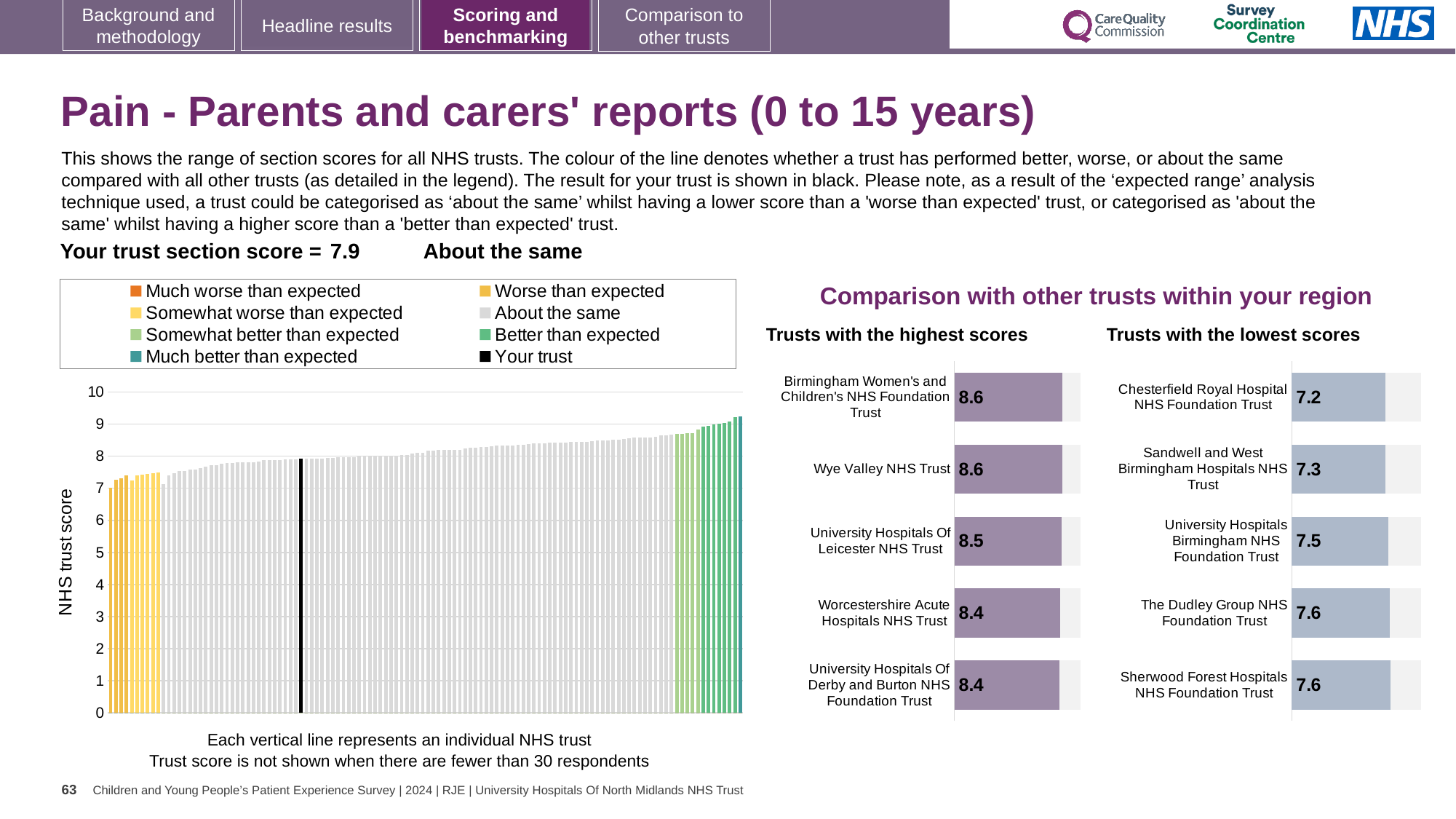
In the 'Trusts with the lowest scores' chart, what is the score for The Dudley Group NHS Foundation Trust? 7.6 In the 'Trusts with the highest scores' chart, which has the higher score: University Hospitals Of Leicester NHS Trust or University Hospitals Of Derby and Burton NHS Foundation Trust? University Hospitals Of Leicester NHS Trust How many trusts are listed in the 'Trusts with the lowest scores' chart? 5 In the 'Trusts with the lowest scores' chart, what is the difference between the scores of Sherwood Forest Hospitals NHS Foundation Trust and Chesterfield Royal Hospital NHS Foundation Trust? 0.4 In the large chart on the left, is the value of the black bar (your trust) greater or less than 7? greater In the 'Trusts with the highest scores' chart, what is the difference between the scores of Birmingham Women's and Children's NHS Foundation Trust and Worcestershire Acute Hospitals NHS Trust? 0.2 In the large chart on the left, do the trust scores rise or fall from left to right? Rise In the 'Trusts with the highest scores' chart, what is the score for University Hospitals Of Leicester NHS Trust? 8.5 In the 'Trusts with the highest scores' chart, what is the score for Wye Valley NHS Trust? 8.6 How many entries does the legend above the large chart on the left list? 8 What type of chart is the large chart on the left showing NHS trust scores? Bar chart In the 'Trusts with the lowest scores' chart, which trust has the lowest score? Chesterfield Royal Hospital NHS Foundation Trust